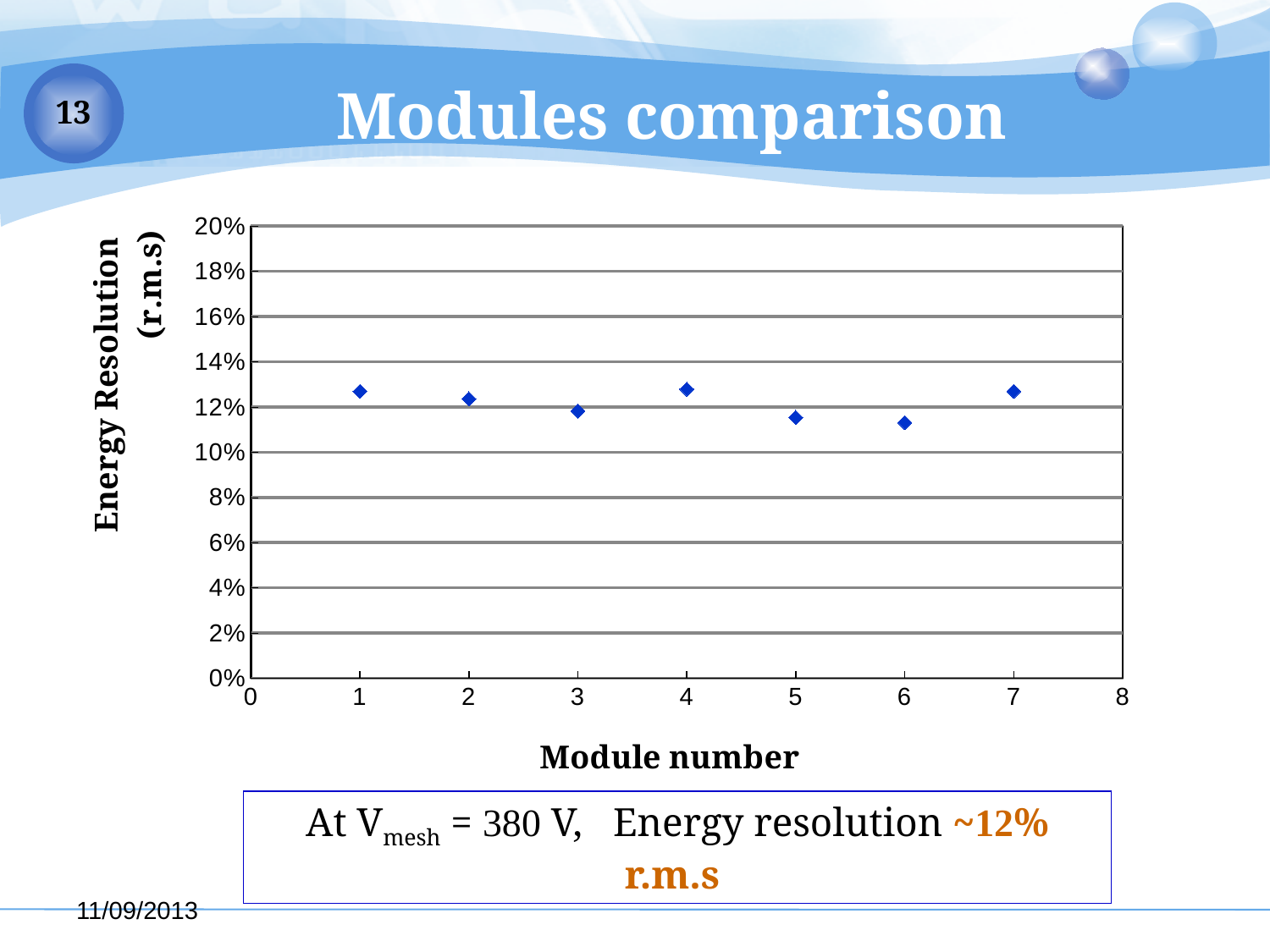
Which has the lower energy resolution, module 1 or module 5? module 5 Is the energy resolution for module 5 greater or less than 12%? less Is the energy resolution for module 6 greater or less than 12%? less Which has the higher energy resolution, module 4 or module 6? module 4 Is the energy resolution for module 1 greater or less than 14%? less How many data points are plotted in the chart? 7 What type of chart is shown on the slide? scatter chart Which has the higher energy resolution, module 7 or module 6? module 7 What is the title of the chart? Modules comparison What is the label of the y axis? Energy Resolution (r.m.s)